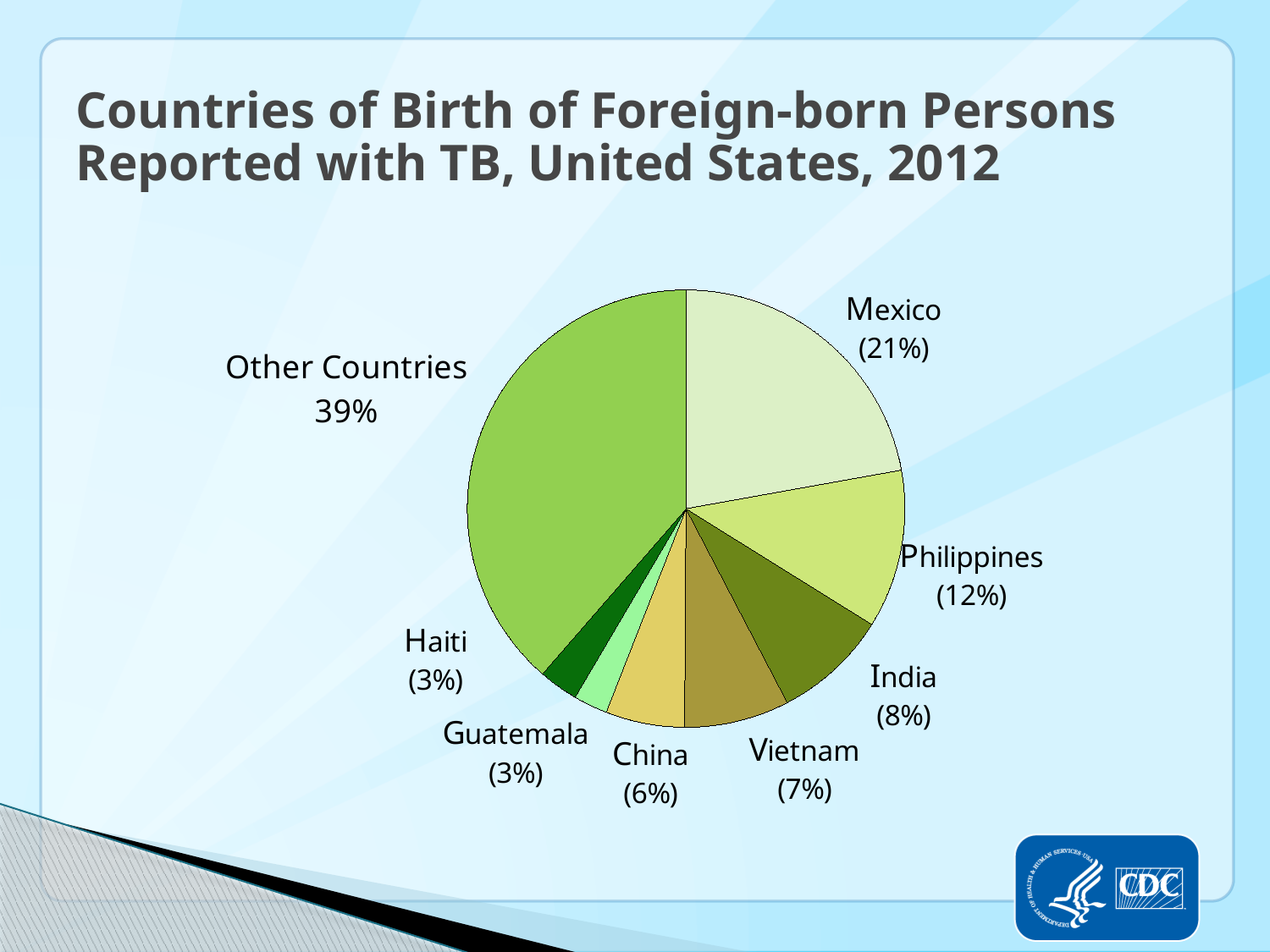
What is the combined share of Haiti and Guatemala? 6% What is the title of the chart? Countries of Birth of Foreign-born Persons Reported with TB, United States, 2012 Which single named country has the largest share? Mexico Which slice of the pie is the largest? Other Countries What percentage is shown for Vietnam? 7% What percentage is shown for the Philippines? 12% What percentage is shown for Other Countries? 39% Which has a larger share, India or China? India How many slices does the pie chart have? 8 What is the difference in percentage points between Mexico and the Philippines? 9 What share of the pie does Mexico account for? 21% What kind of chart is shown on the slide? Pie chart